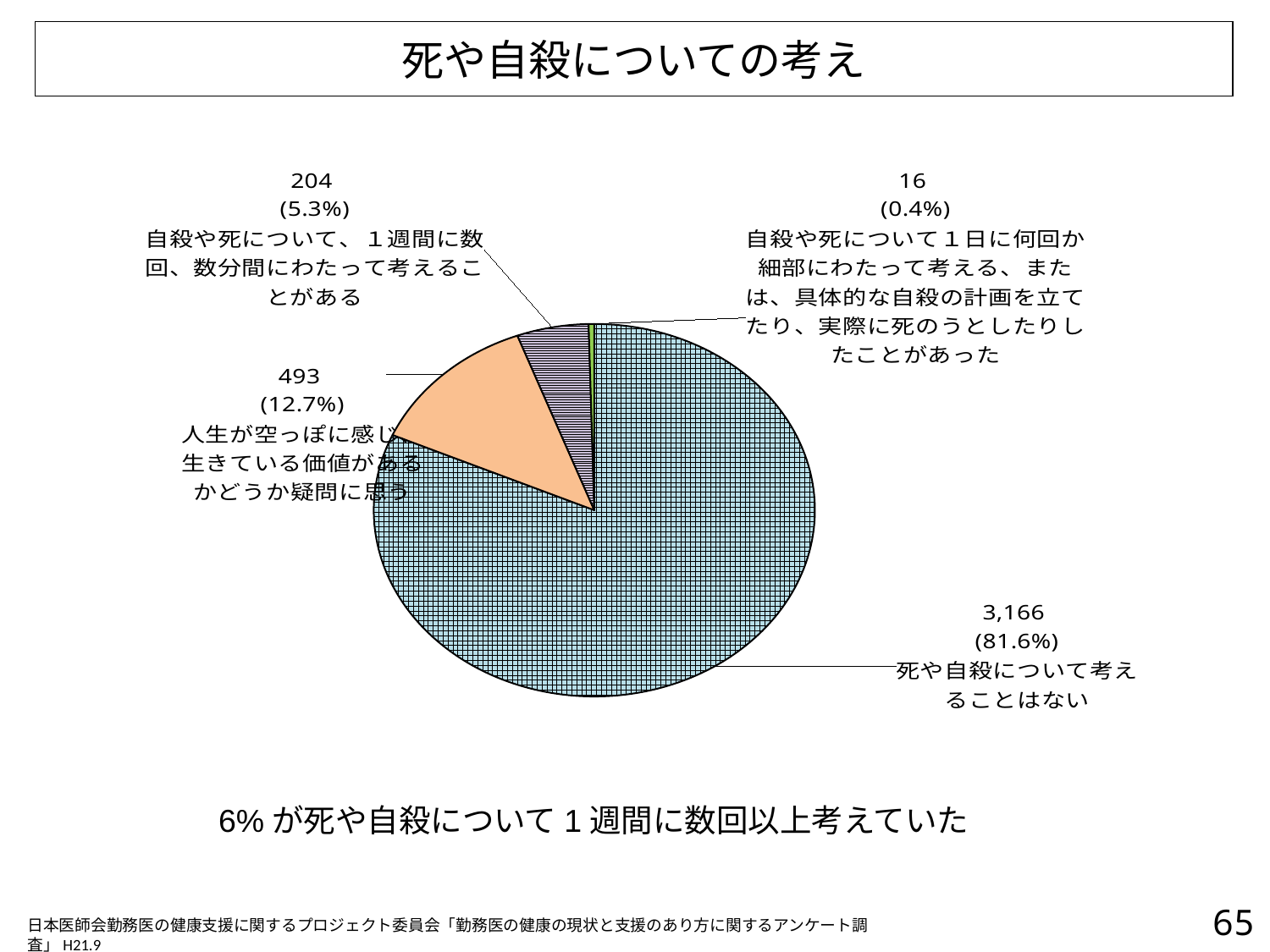
Which category has the smallest slice in the pie chart? 自殺や死について１日に何回か細部にわたって考える、または、具体的な自殺の計画を立てたり、実際に死のうとしたりしたことがあった What is the value for 「死や自殺について考えることはない」? 3,166 What kind of chart is shown on the slide? pie chart What percentage share does 「死や自殺について考えることはない」 have in the pie chart? 81.6% How many slices does the pie chart have? 4 Which category has the largest slice in the pie chart? 死や自殺について考えることはない What is the value for 「人生が空っぽに感じ、生きている価値があるかどうか疑問に思う」? 493 What is the difference between the values for 「人生が空っぽに感じ、生きている価値があるかどうか疑問に思う」 (493) and 「自殺や死について、１週間に数回、数分間にわたって考えることがある」 (204)? 289 What percentage share does 「自殺や死について、１週間に数回、数分間にわたって考えることがある」 have? 5.3% Which is larger: the value for 「人生が空っぽに感じ、生きている価値があるかどうか疑問に思う」 or the value for 「自殺や死について、１週間に数回、数分間にわたって考えることがある」? 人生が空っぽに感じ、生きている価値があるかどうか疑問に思う What is the value for the slice 「自殺や死について１日に何回か細部にわたって考える、または、具体的な自殺の計画を立てたり、実際に死のうとしたりしたことがあった」? 16 What is the title of the chart on the slide? 死や自殺についての考え